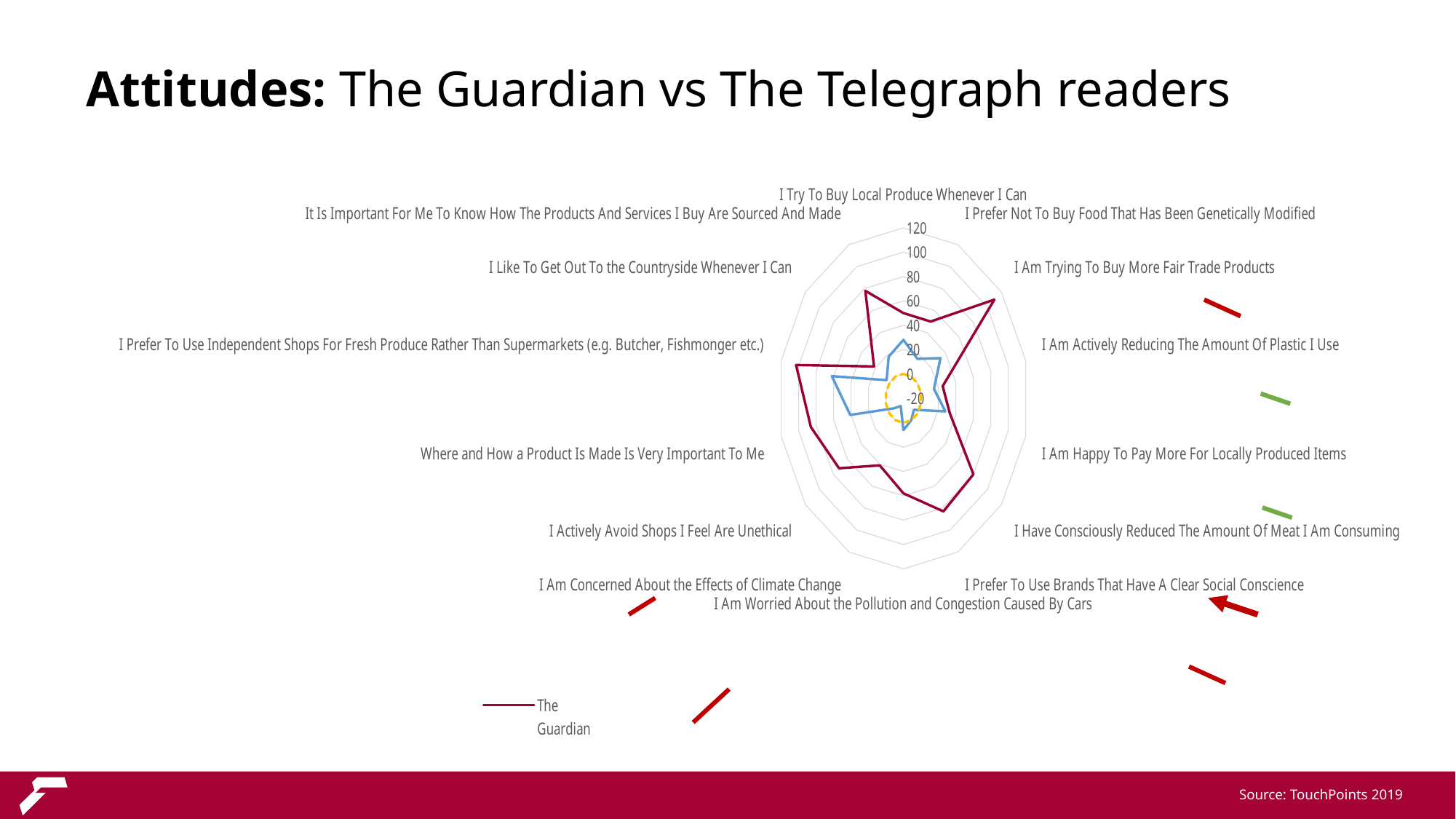
Is the blue line's value for 'I Try To Buy Local Produce Whenever I Can' greater or less than 40? less What is the lowest value labelled on the radar chart's axis? -20 Is the dark red (The Guardian) value for 'I Have Consciously Reduced The Amount Of Meat I Am Consuming' greater or less than 60? greater What is the highest value labelled on the radar chart's axis? 120 How many attitude statements (categories) are plotted around the radar chart? 14 Is the dark red (The Guardian) value for 'I Am Trying To Buy More Fair Trade Products' greater or less than 80? greater For which statement does the dark red (The Guardian) line reach its highest value? I Am Trying To Buy More Fair Trade Products What kind of chart is shown on the slide? Radar chart For 'I Am Trying To Buy More Fair Trade Products', which line has the larger value, the dark red line or the blue line? The dark red line How many data lines are plotted on the radar chart? 3